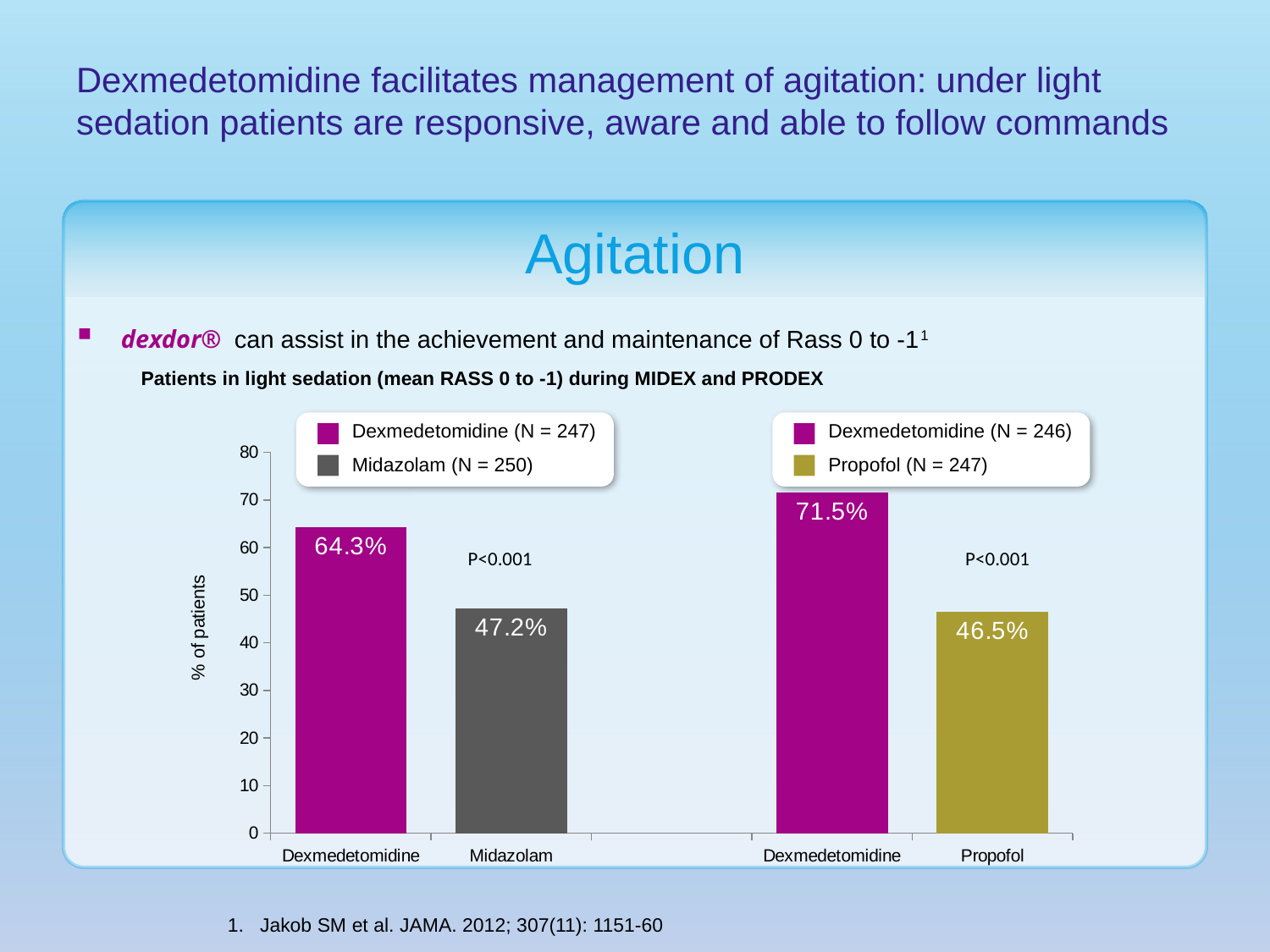
Which bar has the highest value on the chart? Dexmedetomidine (PRODEX, 71.5%) What is the difference between the Dexmedetomidine value and the Propofol value in the PRODEX comparison? 25 percentage points What is the title of the chart? Patients in light sedation (mean RASS 0 to -1) during MIDEX and PRODEX Which bar has the lowest value on the chart? Propofol Which is larger, the value for Midazolam or the value for Propofol? Midazolam What percentage of patients were in light sedation with Midazolam? 47.2% What is the difference between the Dexmedetomidine value and the Midazolam value in the MIDEX comparison? 17.1 percentage points What percentage of patients were in light sedation with Propofol? 46.5% How many bars are plotted on the chart? 4 What type of chart is shown on the slide? Bar chart What is the value for Dexmedetomidine in the MIDEX comparison (left pair of bars, versus Midazolam)? 64.3% What is the value for Dexmedetomidine in the PRODEX comparison (right pair of bars, versus Propofol)? 71.5%